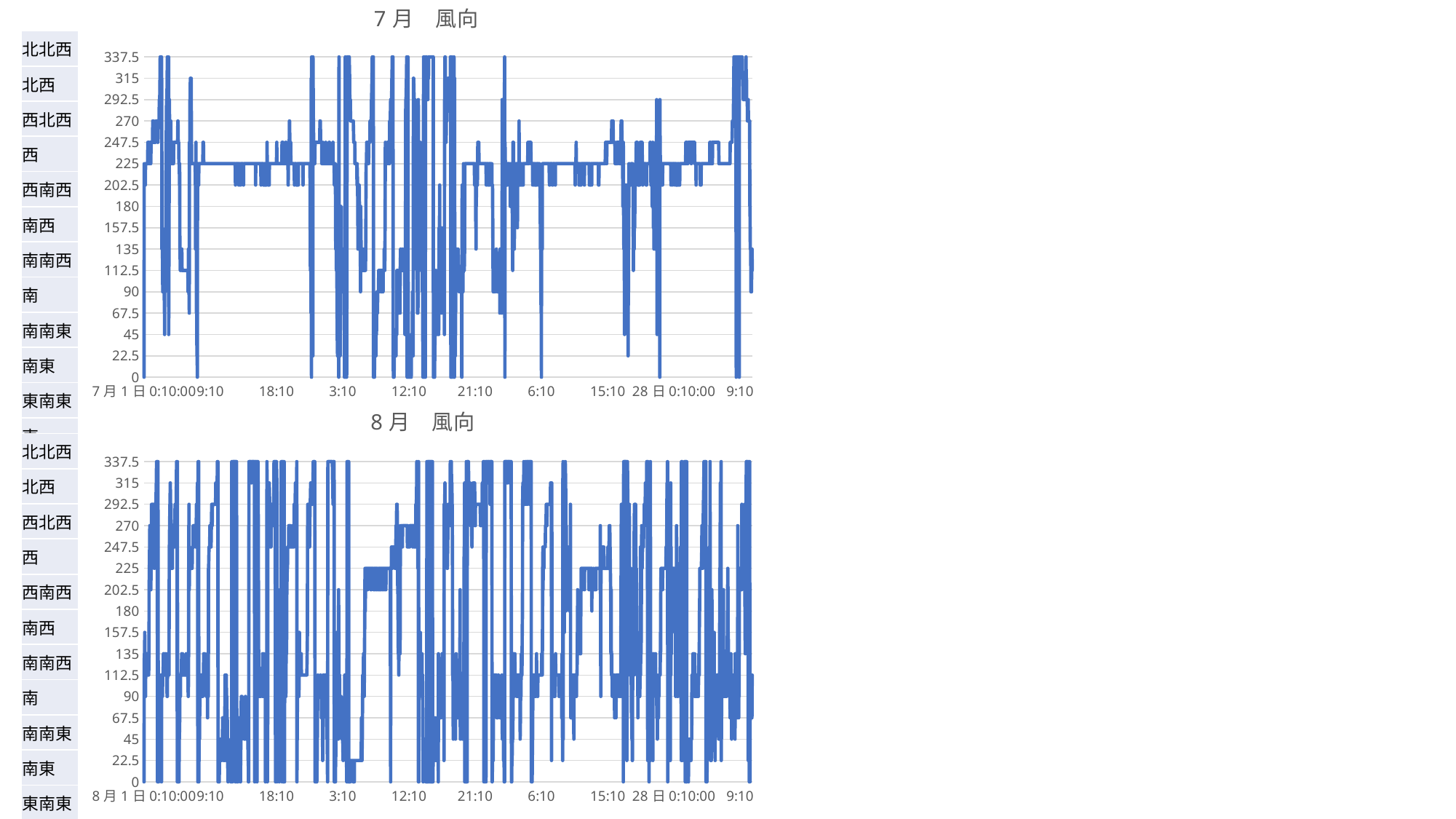
In the "7月 風向" chart, how many data series are plotted? 1 In the "8月 風向" chart, how many labelled tick values are shown on the horizontal axis? 10 In the "8月 風向" chart, is the value of the flat stretch just before the 12:10 label greater or less than 180? greater What is the title of the top chart on the slide? 7月 風向 What is the title of the bottom chart on the slide? 8月 風向 In the "8月 風向" chart, is the value of the flat stretch just after the 3:10 label greater or less than 90? less In the "8月 風向" chart, how many data series are plotted? 1 What kind of chart is the "7月 風向" chart at the top of the slide? line chart How many charts are shown on the slide? 2 What kind of chart is the "8月 風向" chart at the bottom of the slide? line chart In the "7月 風向" chart, how many labelled tick values are shown on the vertical axis? 16 In the "7月 風向" chart, is the value of the long flat stretch between 9:10 and 18:10 on 7月1日 greater or less than 180? greater